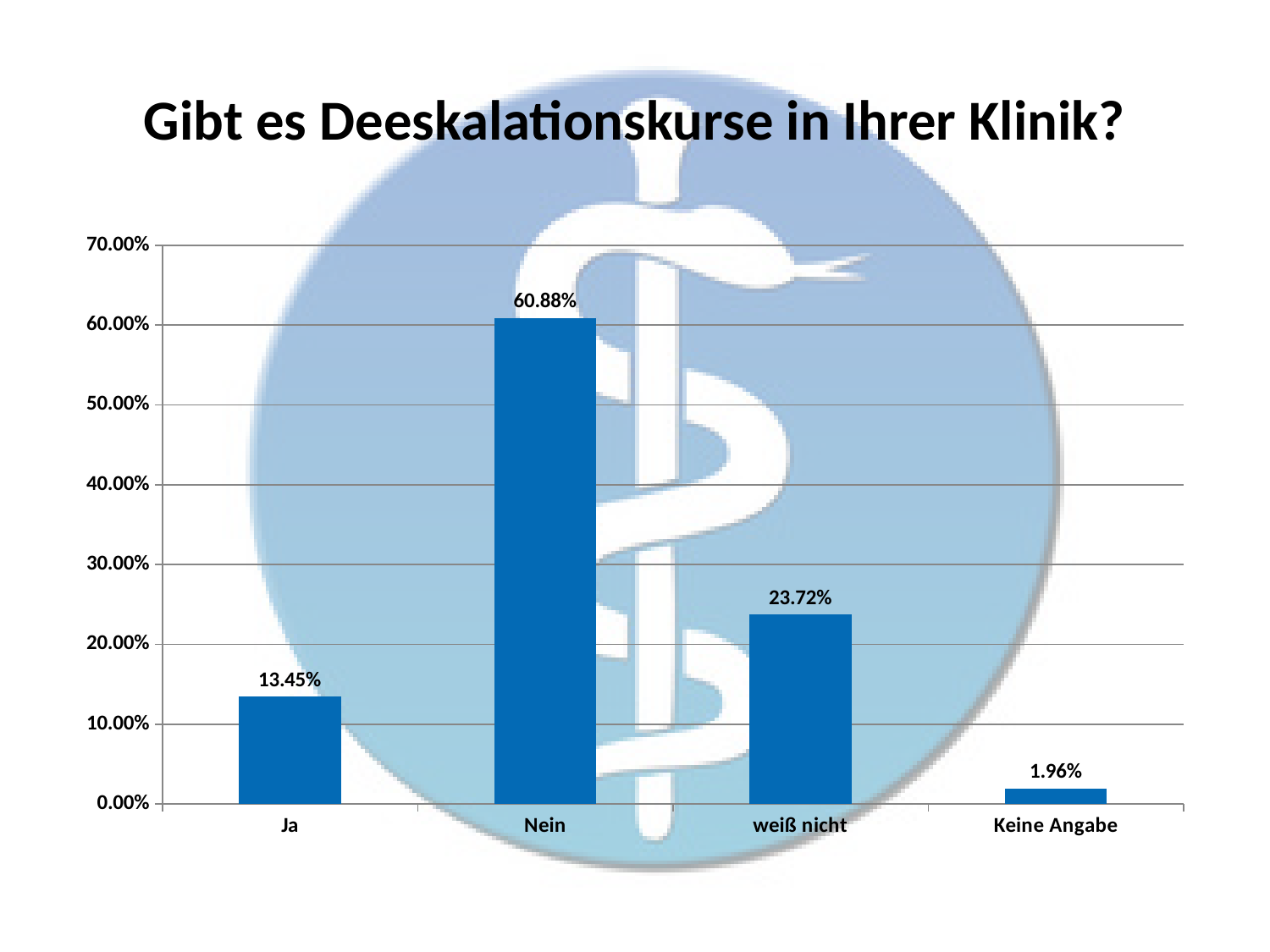
What is the difference between the values for "Nein" and "weiß nicht"? 37.16% Which category has the highest value? Nein What is the difference between the values for "weiß nicht" and "Ja"? 10.27% Is the value for "Nein" greater or less than 50.00%? greater What is the value for "weiß nicht"? 23.72% How many categories are shown on the x axis? 4 What is the value for "Nein"? 60.88% Which category has the lowest value? Keine Angabe What kind of chart is shown on the slide? Bar chart What is the value for "Ja"? 13.45% Which is larger, the value for "Ja" or the value for "weiß nicht"? weiß nicht What is the value for "Keine Angabe"? 1.96%